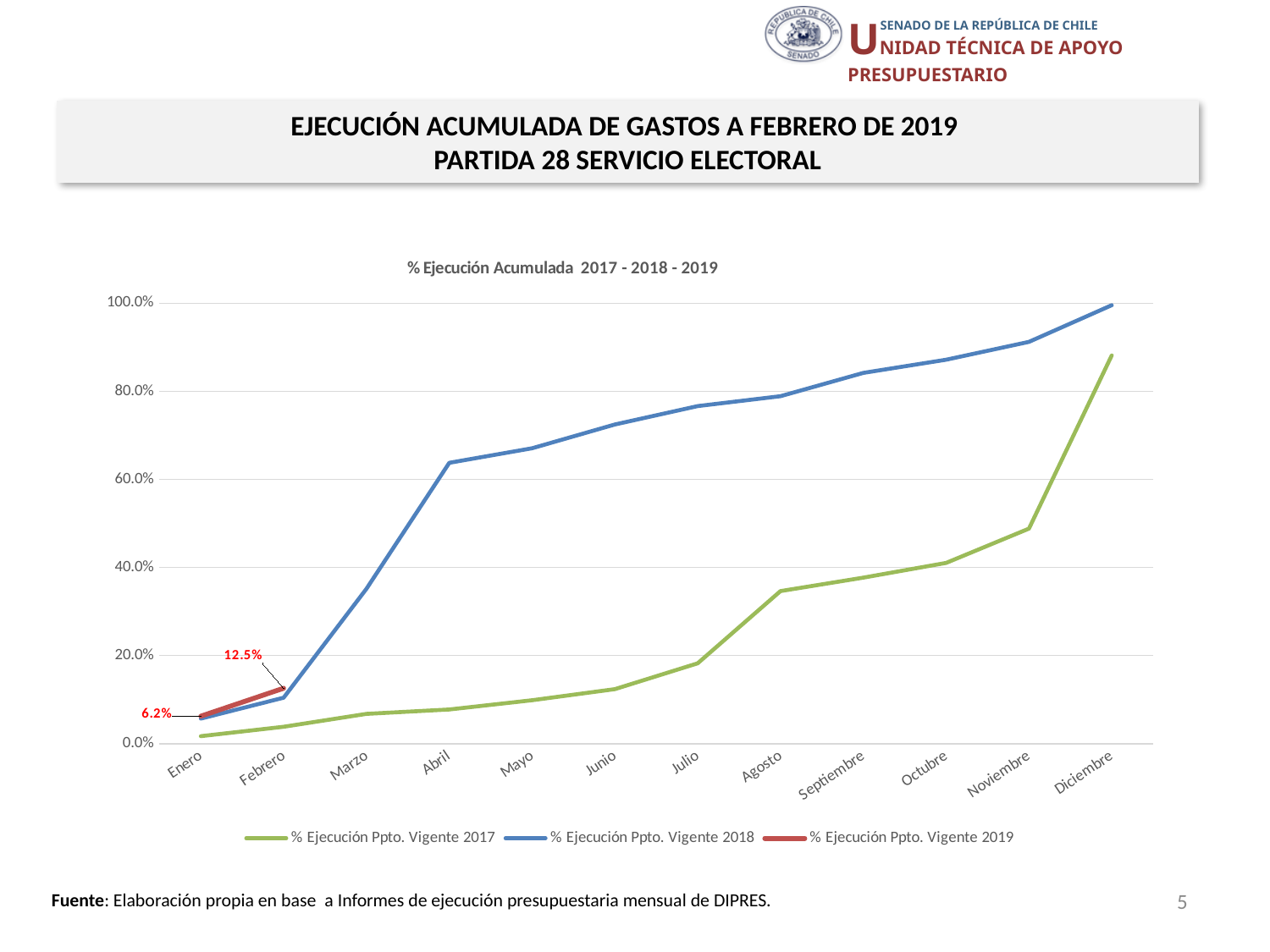
By how much did % Ejecución Ppto. Vigente 2019 increase from Enero to Febrero? 6.3% What kind of chart is shown on the slide? Line chart Is the value for % Ejecución Ppto. Vigente 2017 in Agosto greater or less than 40%? less In which month does % Ejecución Ppto. Vigente 2018 reach its highest value? Diciembre What is the title of the chart? % Ejecución Acumulada 2017 - 2018 - 2019 Does the % Ejecución Ppto. Vigente 2018 line rise or fall from Enero to Diciembre? Rise What is the value of % Ejecución Ppto. Vigente 2019 in Enero? 6.2% How many months are shown on the x axis? 12 Is the value for % Ejecución Ppto. Vigente 2018 in Abril greater or less than 60%? greater In Diciembre, which series is larger: % Ejecución Ppto. Vigente 2017 or % Ejecución Ppto. Vigente 2018? % Ejecución Ppto. Vigente 2018 What is the value of % Ejecución Ppto. Vigente 2019 in Febrero? 12.5% How many series does the legend list? 3